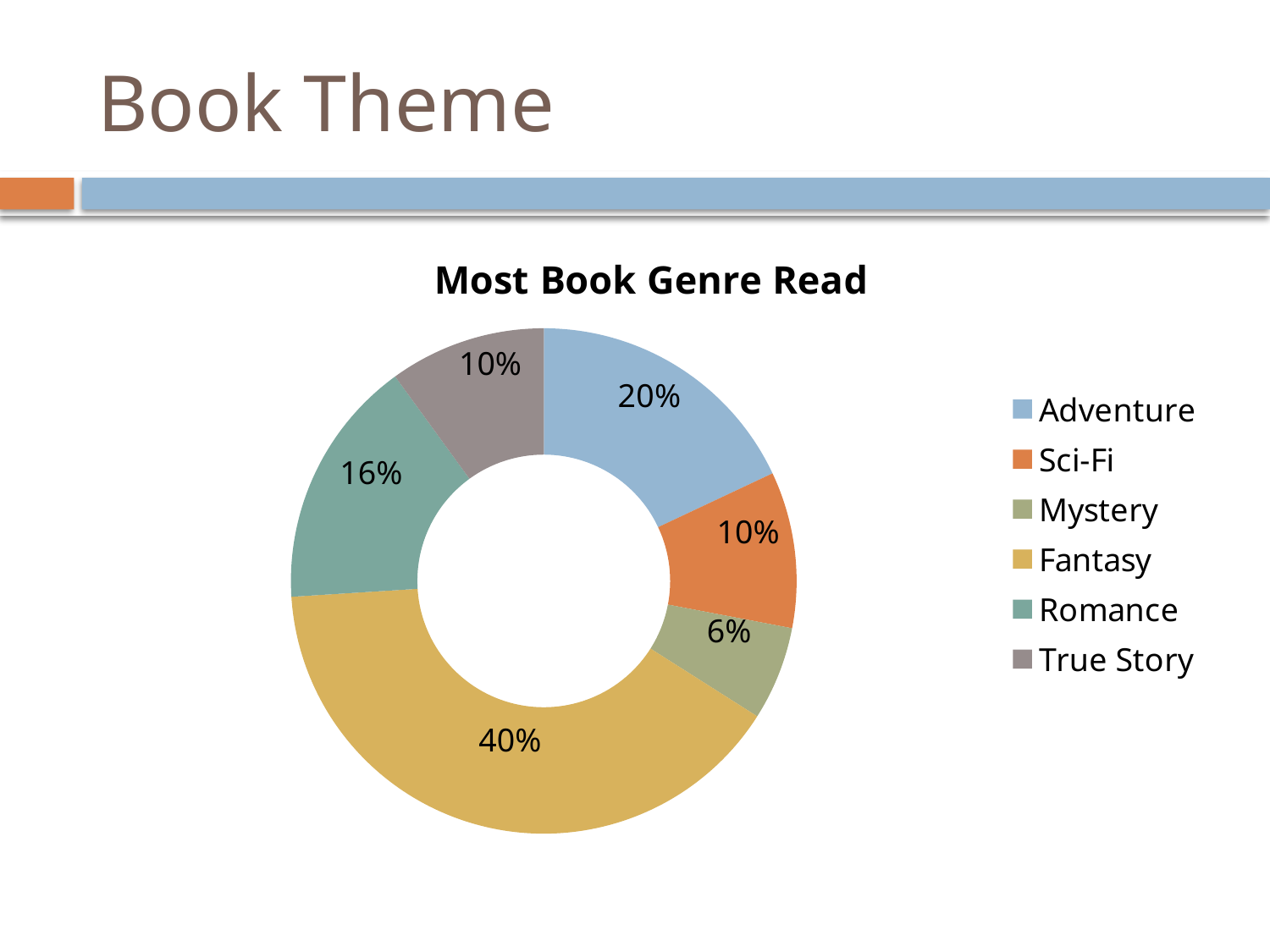
What is the value shown for Adventure? 20% What percentage is shown for Romance? 16% Which genre has the smallest share of the chart? Mystery What kind of chart is shown on the slide? Doughnut chart Which genre has the largest share of the chart? Fantasy Which two genres share the same value of 10%? Sci-Fi and True Story What is the title of the chart? Most Book Genre Read Which is larger, the share for Romance or the share for Sci-Fi? Romance What share of the doughnut chart does Fantasy account for? 40% What is the value for Mystery? 6% How many genres are shown in the chart? 6 What is the difference between the Fantasy share and the Adventure share? 20%